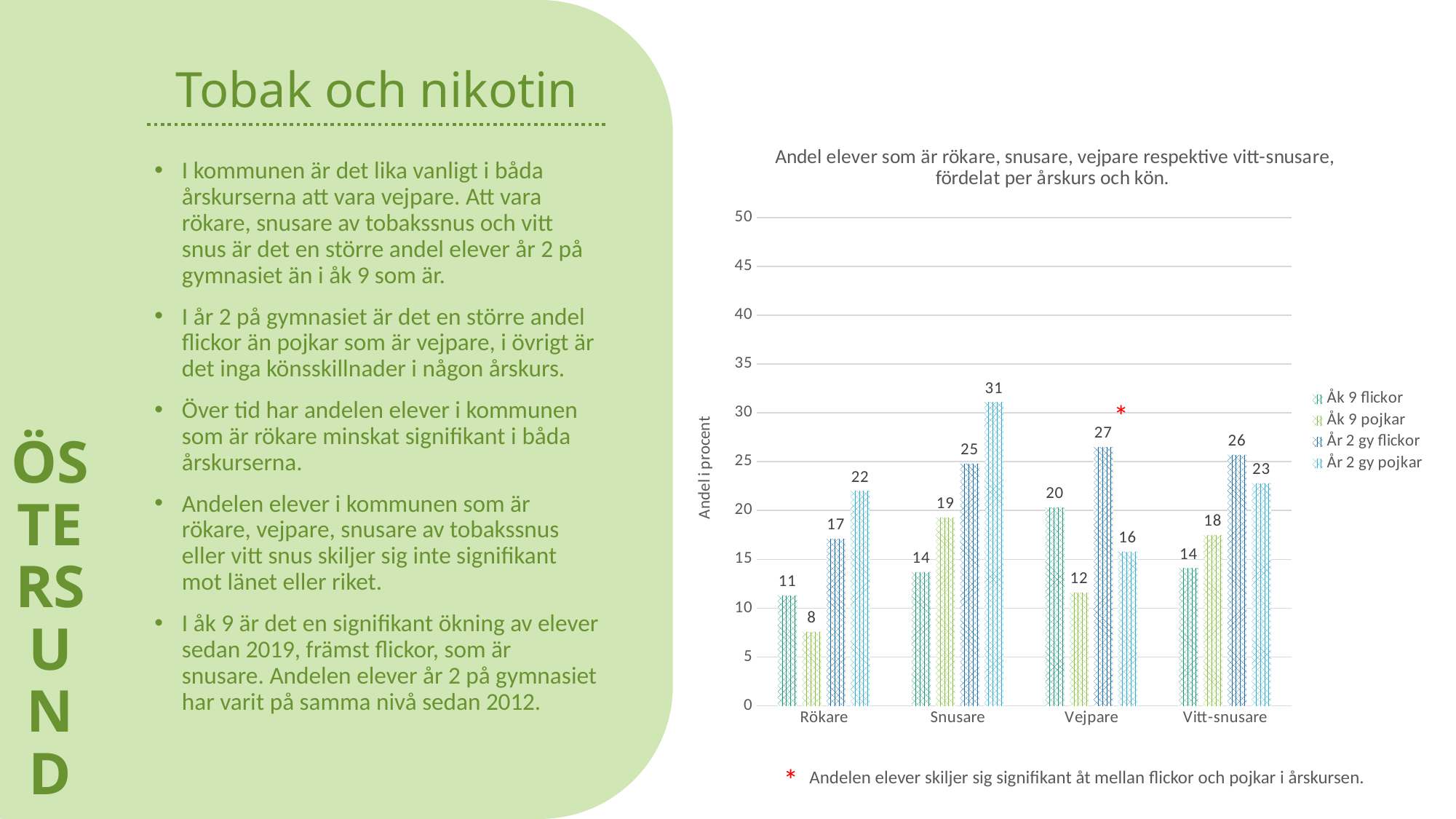
What is the difference between År 2 gy flickor and Åk 9 flickor in the Snusare category? 11 What is the value for År 2 gy flickor in the Vejpare category? 27 What is the value for År 2 gy pojkar in the Snusare category? 31 What is the value for Åk 9 flickor in the Vitt-snusare category? 14 How many categories are shown on the x axis? 4 In the Vejpare category, which is larger: Åk 9 flickor or Åk 9 pojkar? Åk 9 flickor What type of chart is shown on the slide? Bar chart How many series does the legend list? 4 What is the label of the y axis? Andel i procent What is the value for Åk 9 pojkar in the Rökare category? 8 Which category has the lowest value for Åk 9 pojkar? Rökare Which category has the highest value for År 2 gy pojkar? Snusare